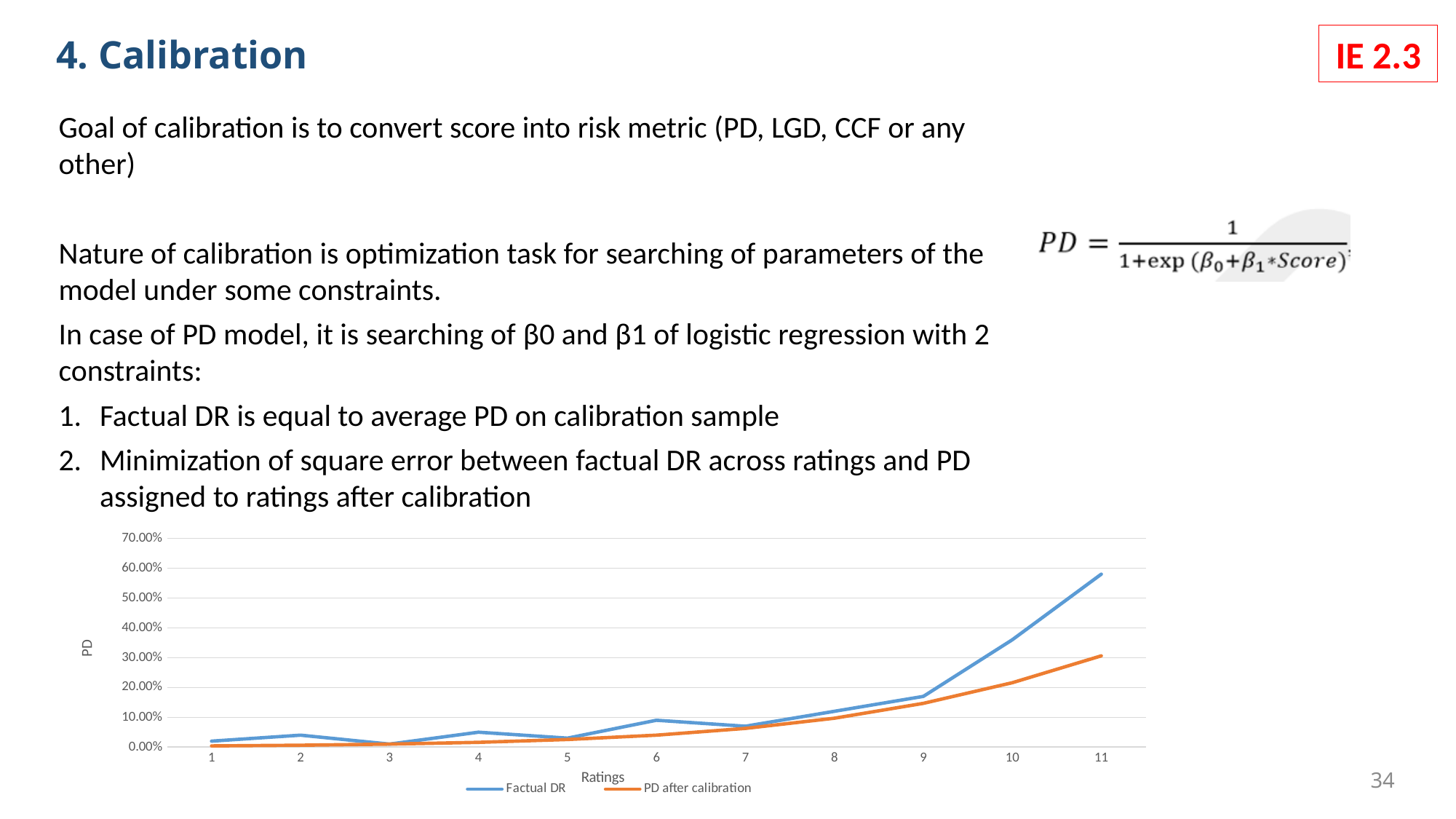
Is the Factual DR value at rating 10 greater or less than 30.00%? greater Is the PD after calibration value at rating 11 greater or less than 20.00%? greater What kind of chart is shown on the slide? line chart At rating 11, which series has the larger value, Factual DR or PD after calibration? Factual DR At which rating does the PD after calibration series reach its highest value? 11 How many series does the chart's legend list? 2 Is the Factual DR value at rating 11 greater or less than 50.00%? greater What is the title of the x axis of the chart? Ratings Do the PD after calibration values generally rise or fall as the rating increases from 1 to 11? rise Which series is shown in orange in the chart? PD after calibration At which rating does the Factual DR series reach its highest value? 11 How many ratings are plotted along the x axis of the chart? 11